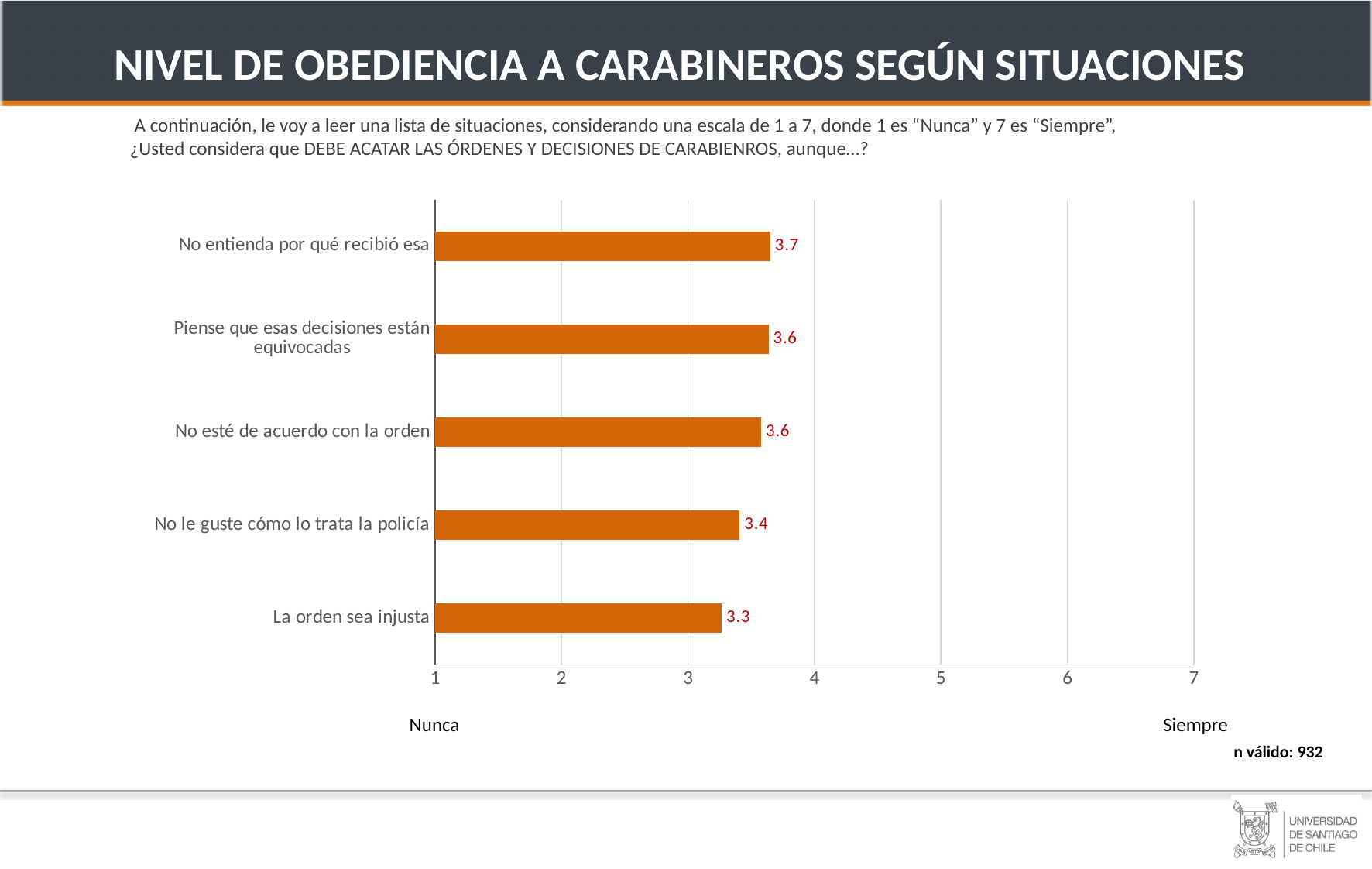
What is the valid sample size (n válido) shown on the slide? 932 What kind of chart is shown on the slide? Bar chart What is the value for "No esté de acuerdo con la orden"? 3.6 How many situations (categories) are shown in the chart? 5 What is the value for "No le guste cómo lo trata la policía"? 3.4 What is the value for "No entienda por qué recibió esa"? 3.7 Which situation has the lowest value? La orden sea injusta What is the difference between the values for "No entienda por qué recibió esa" and "La orden sea injusta"? 0.4 Is the value for "No entienda por qué recibió esa" greater or less than 4? less Which is larger, the value for "No le guste cómo lo trata la policía" or the value for "La orden sea injusta"? No le guste cómo lo trata la policía What is the value for "La orden sea injusta"? 3.3 Which situation has the highest value? No entienda por qué recibió esa